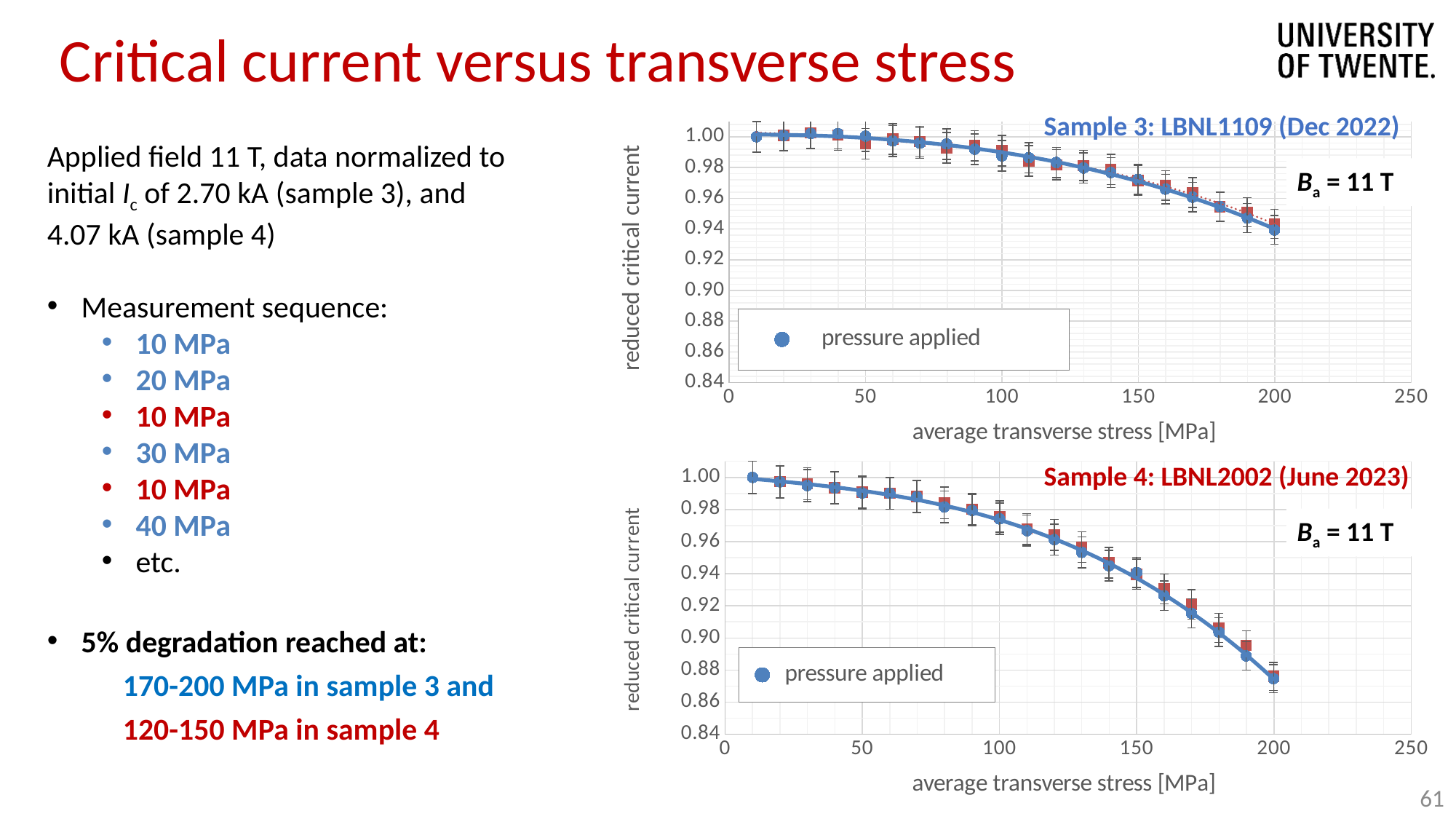
In the Sample 4: LBNL2002 (June 2023) chart, is the reduced critical current at 200 MPa greater or less than 0.90? less What is the x-axis label of the Sample 3: LBNL1109 (Dec 2022) chart? average transverse stress [MPa] In the Sample 3: LBNL1109 (Dec 2022) chart, which x-axis value has the lowest reduced critical current? 200 In the Sample 3: LBNL1109 (Dec 2022) chart, is the reduced critical current at 200 MPa greater or less than 0.96? less In the Sample 4: LBNL2002 (June 2023) chart, does the reduced critical current rise or fall as the average transverse stress increases? fall In the Sample 3: LBNL1109 (Dec 2022) chart, is the reduced critical current at 100 MPa greater or less than 0.98? greater How many entries does the legend of the Sample 4: LBNL2002 (June 2023) chart list? 1 What kind of chart is the Sample 3: LBNL1109 (Dec 2022) chart? scatter chart with a fitted line At 200 MPa, which sample has the higher reduced critical current, Sample 3 (top chart) or Sample 4 (bottom chart)? Sample 3 In the Sample 3: LBNL1109 (Dec 2022) chart, does the reduced critical current rise or fall along the x axis? fall